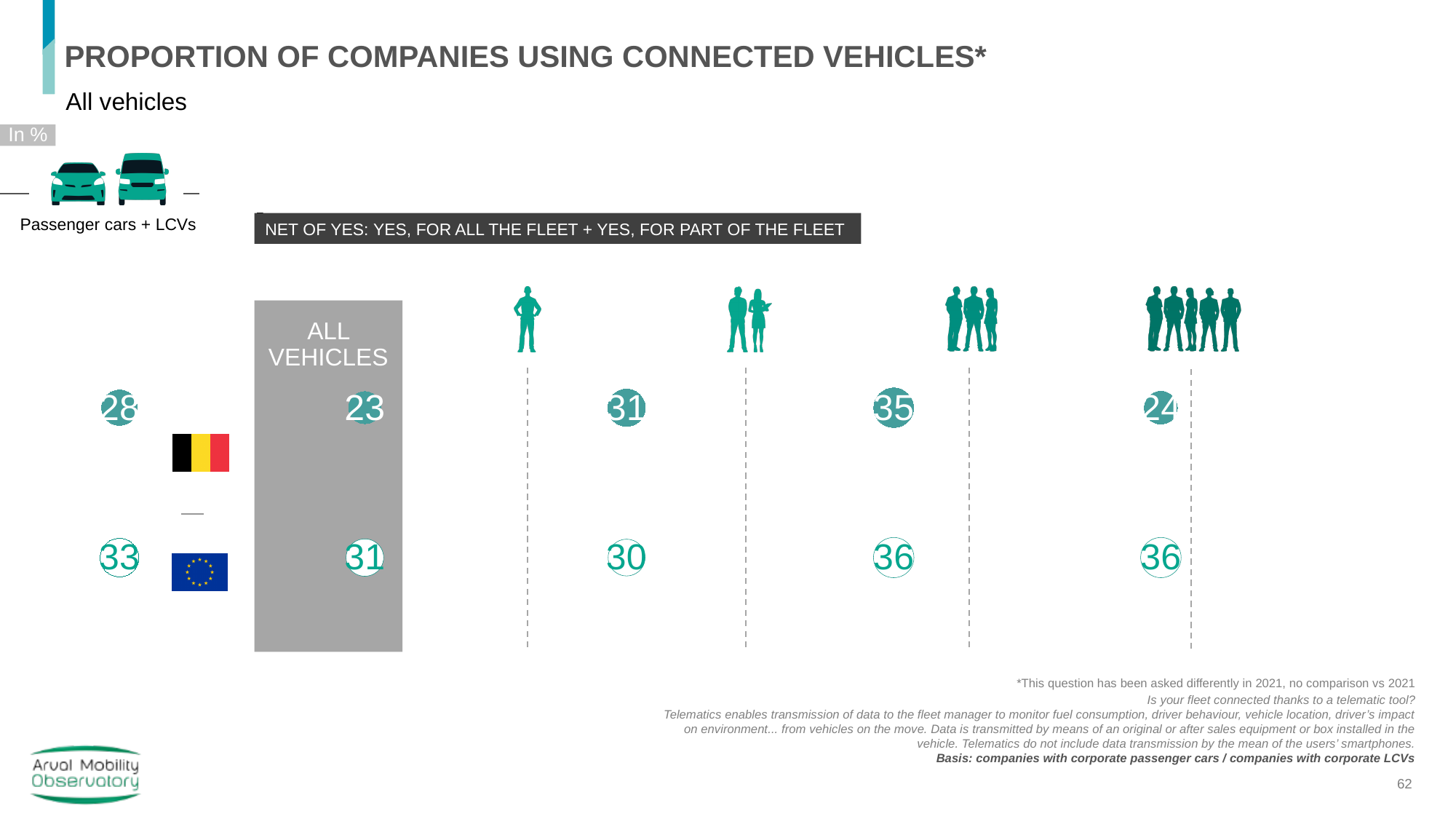
What is the difference between the Europe and Belgium values in the ALL VEHICLES column? 8 What is the title of the chart on the slide? PROPORTION OF COMPANIES USING CONNECTED VEHICLES* What is the lowest value shown in the Europe row? 30 In what unit are the values on the slide expressed? In % What is the ALL VEHICLES value for Belgium (Belgian flag row)? 23 What is the ALL VEHICLES value for Europe (EU flag row)? 31 What is the highest value shown in the Europe row? 36 In the column marked with the largest group of person icons (rightmost), which is higher: Belgium or Europe? Europe In the ALL VEHICLES column, which is higher: Belgium or Europe? Europe What is the lowest value shown in the Belgium row? 23 What is the highest value shown in the Belgium row? 35 In the column marked with a single person icon, what is the value for Belgium? 31